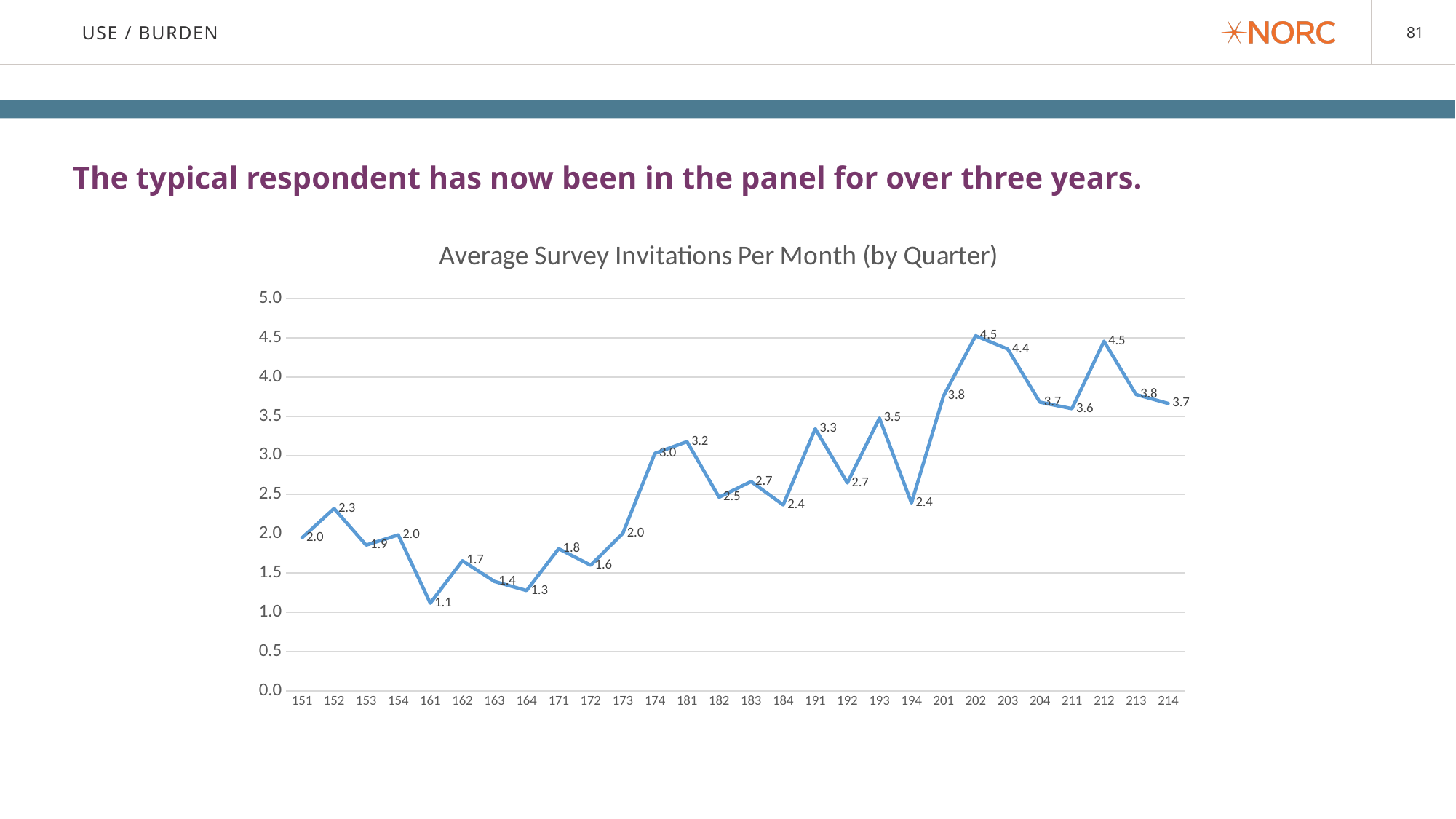
What is the value plotted for quarter 214, the last point on the chart? 3.7 What is the average survey invitations per month for quarter 161? 1.1 What is the difference between the value for quarter 202 and the value for quarter 151? 2.5 What is the title of the chart? Average Survey Invitations Per Month (by Quarter) How many quarters are plotted on the x axis? 28 What is the highest value shown on the chart? 4.5 Is the value for quarter 212 greater or less than 4.0? greater What kind of chart is shown on the slide? line chart What is the value plotted for quarter 174? 3.0 Overall, do the values rise or fall from quarter 151 to quarter 214? rise Which quarter has the larger value, 193 or 183? 193 Which quarter has the lowest average survey invitations per month? 161